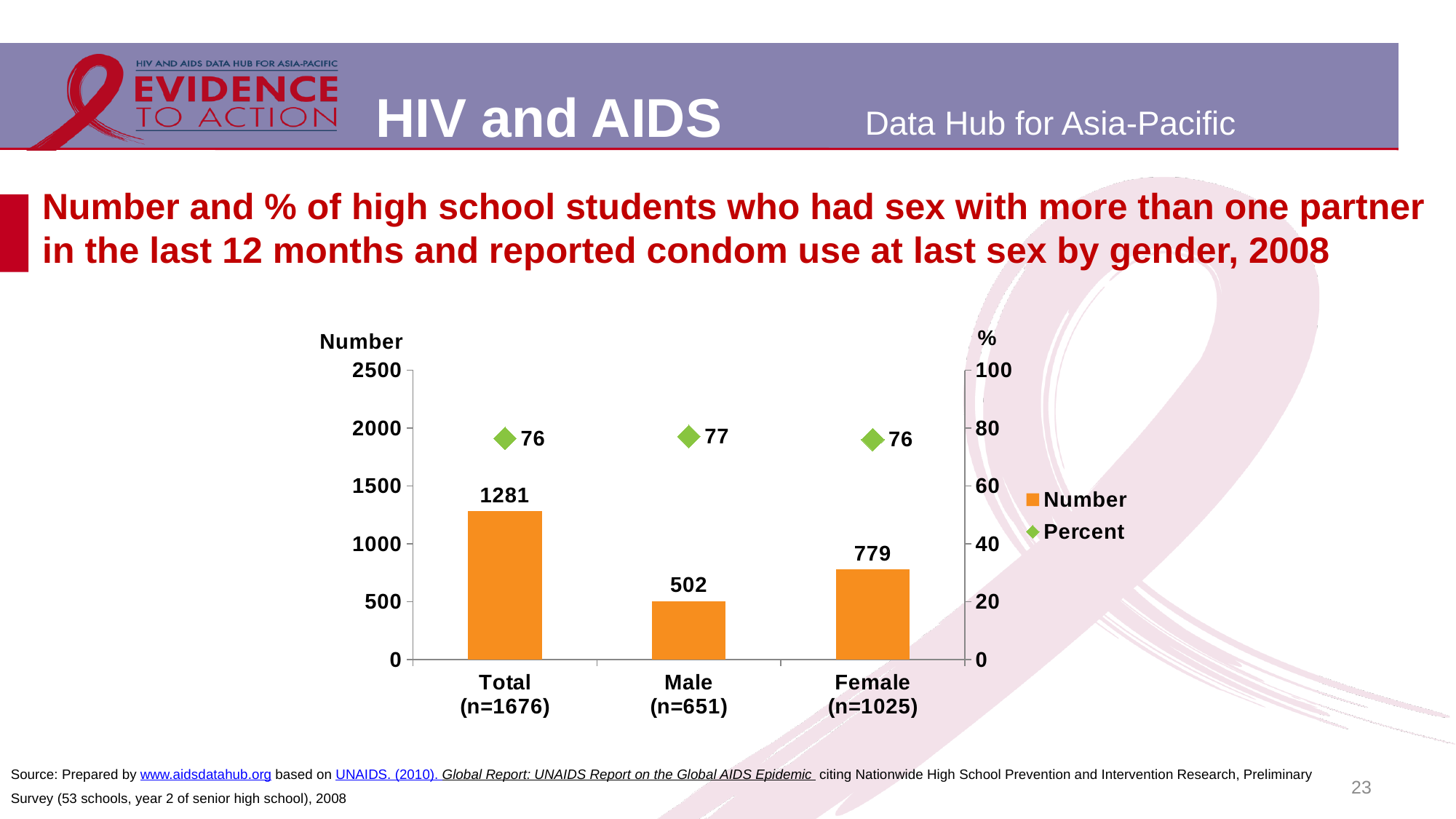
How many categories are shown on the x axis? 3 How many series does the legend list? 2 What is the Percent value for Male (n=651)? 77 What is the Number value for Female (n=1025)? 779 What is the Percent value for Female (n=1025)? 76 What are the two series named in the legend? Number and Percent What is the difference between the Number values for Female (n=1025) and Male (n=651)? 277 Which category has the lowest Number value? Male (n=651) Which category has the highest Number value? Total (n=1676) What is the Number value for Total (n=1676)? 1281 Which is larger, the Number value for Male (n=651) or for Female (n=1025)? Female (n=1025) What is the Number value for Male (n=651)? 502